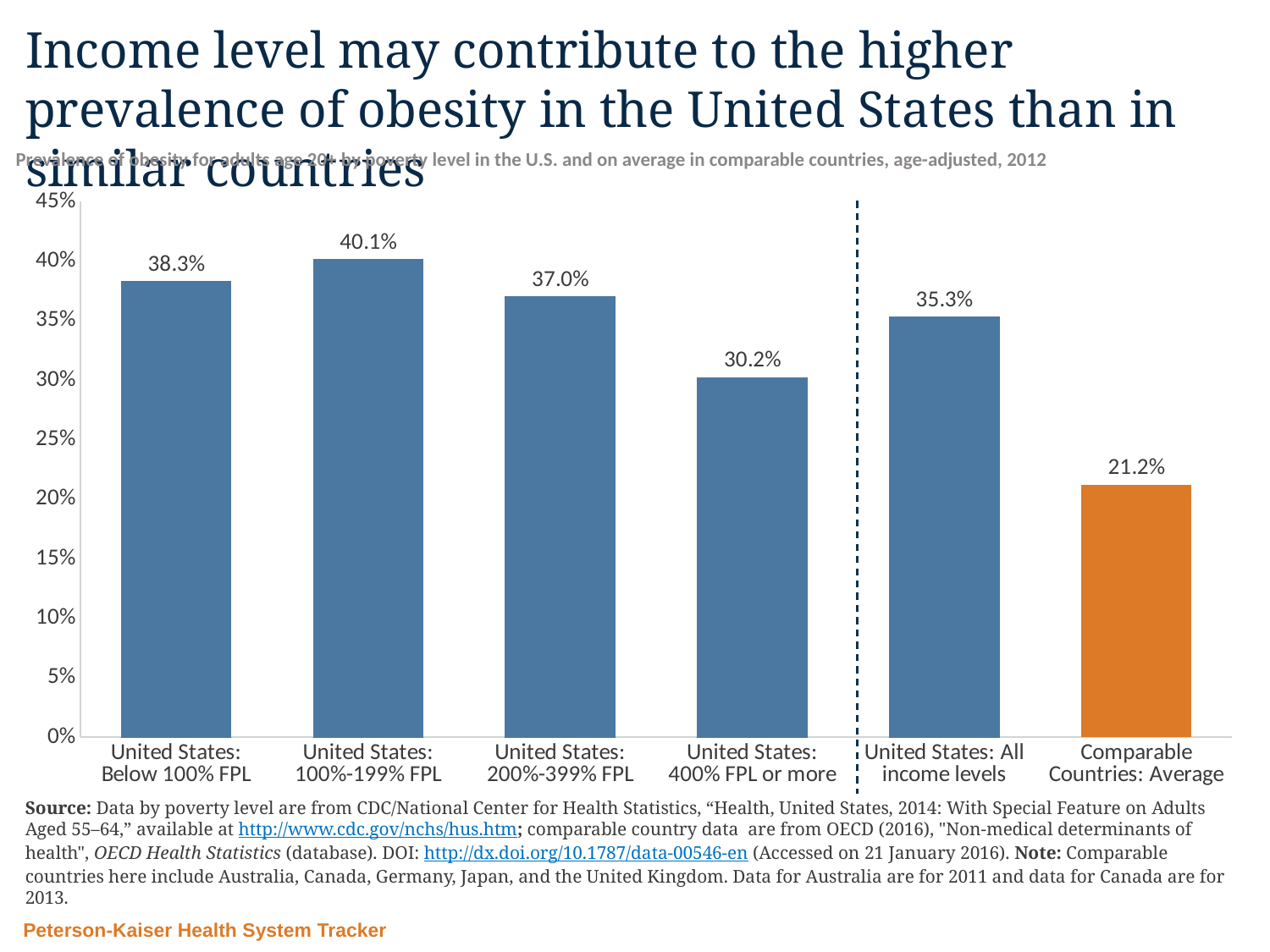
Which category has the lowest obesity prevalence? Comparable Countries: Average What is the difference between United States: All income levels and Comparable Countries: Average? 14.1% What is the obesity prevalence for United States: Below 100% FPL? 38.3% Which bar is coloured orange rather than blue? Comparable Countries: Average What is the value shown for Comparable Countries: Average? 21.2% What is the value shown for United States: All income levels? 35.3% Which is larger: the value for United States: 200%-399% FPL or United States: Below 100% FPL? United States: Below 100% FPL What is the obesity prevalence for United States: 400% FPL or more? 30.2% How many bars are shown in the chart? 6 What is the difference between United States: 100%-199% FPL and United States: 400% FPL or more? 9.9% What kind of chart is shown on the slide? Bar chart Which category has the highest obesity prevalence? United States: 100%-199% FPL